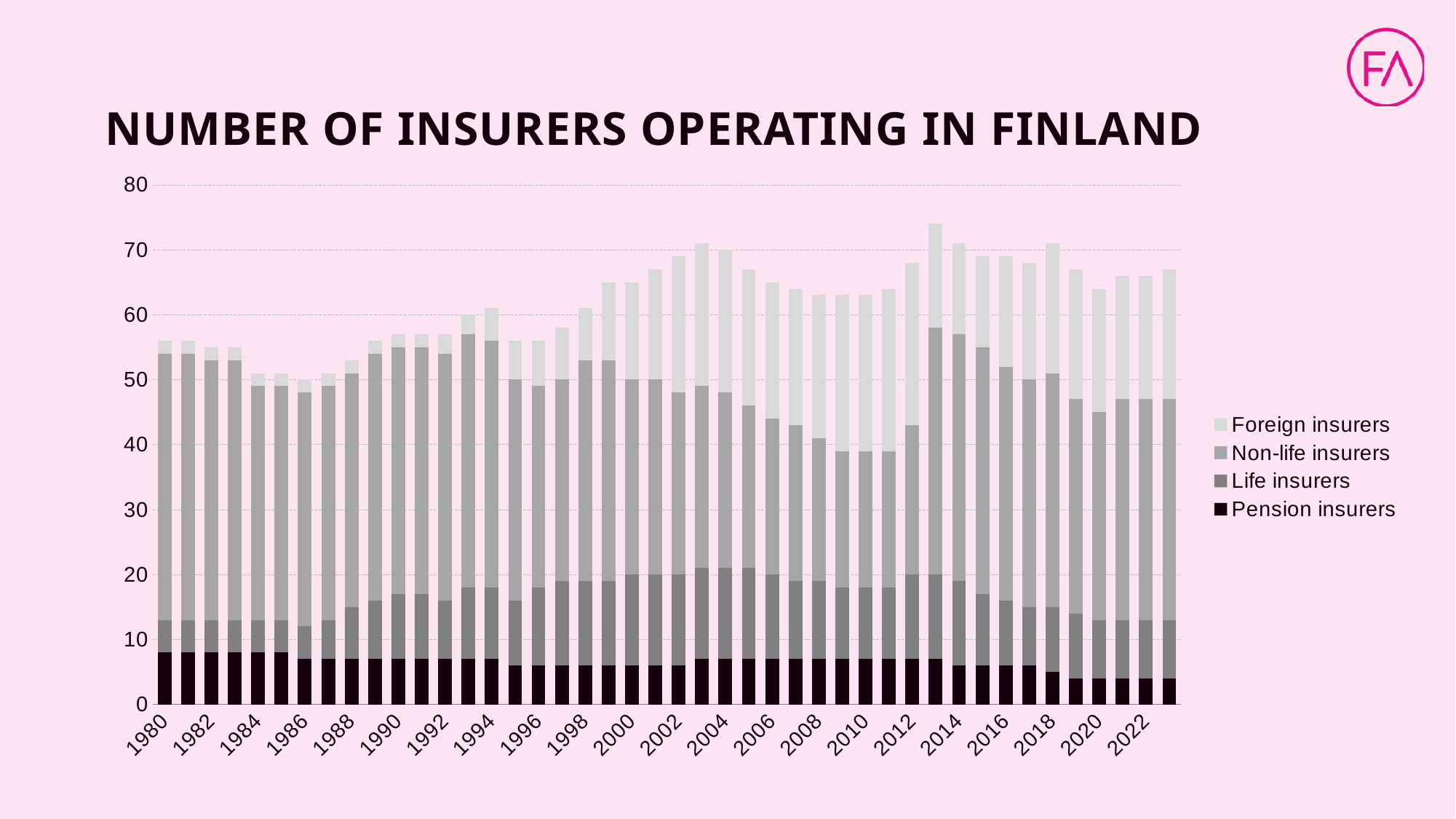
Is the total number of insurers in 2010 greater or less than 70? less Which series is shown at the bottom of each stacked bar, in the darkest colour? Pension insurers Does the foreign insurers segment generally rise or fall from 1980 to 2023? Rise Which year has the highest total number of insurers? 2013 Is the total number of insurers in 1986 greater or less than 60? less Which year has the larger total number of insurers, 1980 or 2023? 2023 What is the title of the chart? NUMBER OF INSURERS OPERATING IN FINLAND Is the number of pension insurers in 1980 greater or less than 10? less How many series does the legend list? 4 What kind of chart is shown on the slide? Stacked bar chart Does the number of pension insurers rise or fall from 1980 to 2023? Fall